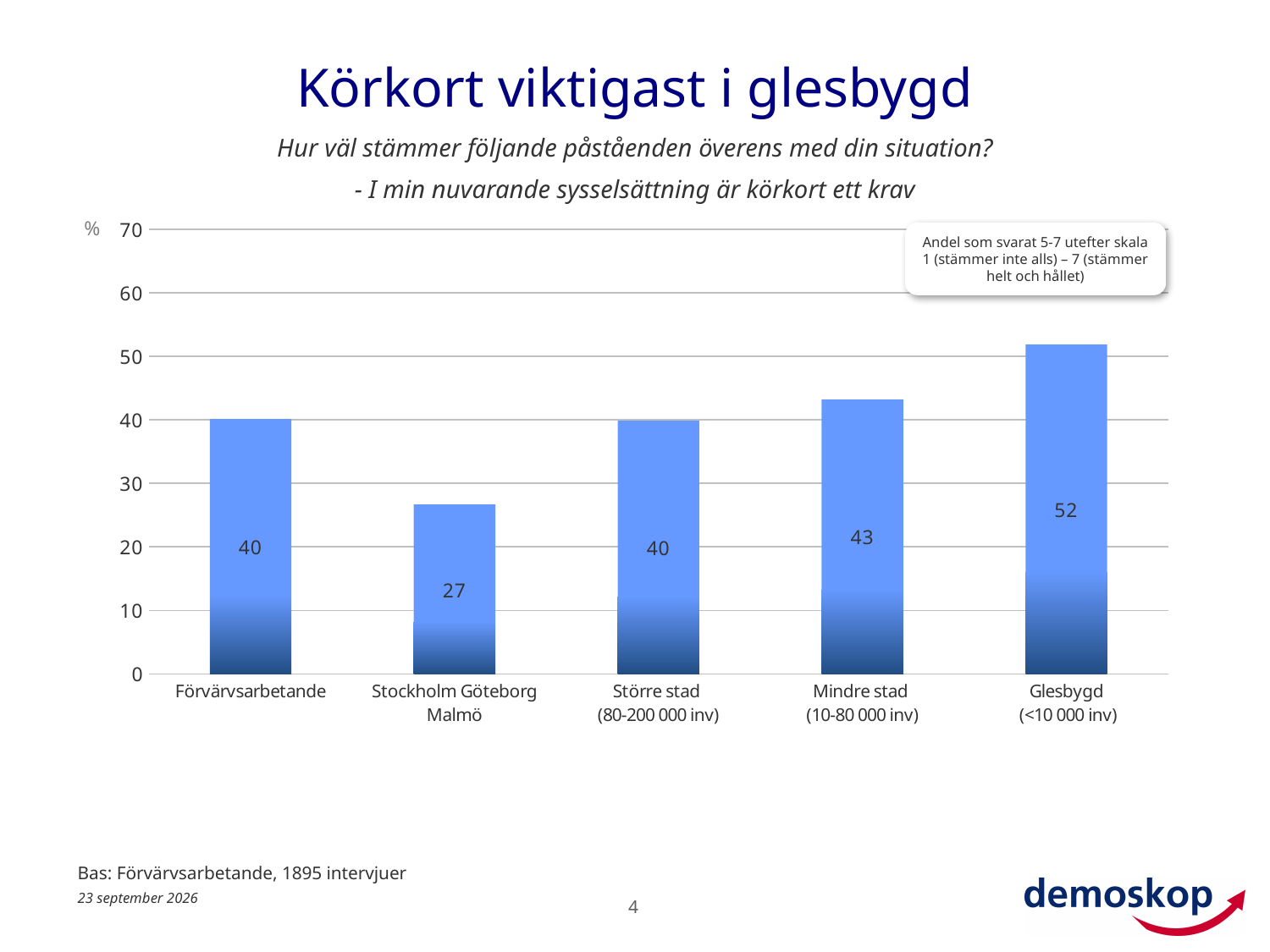
What is the value for Stockholm Göteborg Malmö? 27 What is the difference between the values for Glesbygd (<10 000 inv) and Stockholm Göteborg Malmö? 25 What kind of chart is shown on the slide? bar chart What is the value for Glesbygd (<10 000 inv)? 52 How many categories are shown on the x axis? 5 Which category has the highest value? Glesbygd (<10 000 inv) Is the value for Glesbygd (<10 000 inv) greater or less than 50? greater What is the title of the slide? Körkort viktigast i glesbygd Which is larger, the value for Mindre stad (10-80 000 inv) or the value for Större stad (80-200 000 inv)? Mindre stad (10-80 000 inv) Which category has the lowest value? Stockholm Göteborg Malmö What is the value for Förvärvsarbetande? 40 What is the value for Mindre stad (10-80 000 inv)? 43